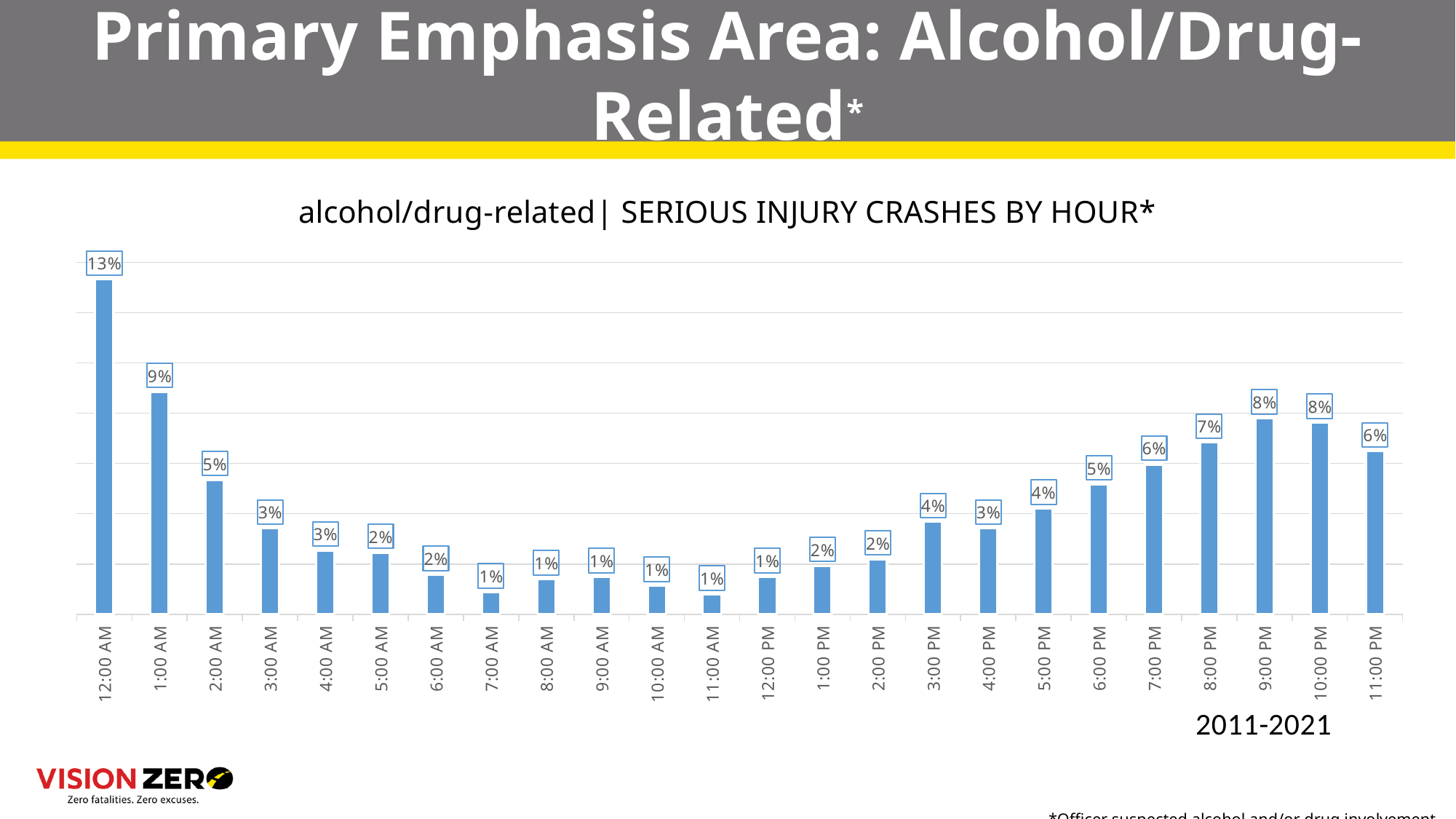
What is the value shown for 3:00 PM? 4% What is the value shown for 2:00 AM? 5% What is the difference between the values for 8:00 PM and 11:00 PM? 1% Which is larger, the value for 6:00 PM or the value for 7:00 PM? 7:00 PM Which is larger, the value for 1:00 AM or the value for 10:00 PM? 1:00 AM What is the difference between the values for 12:00 AM and 1:00 AM? 4% What kind of chart is shown on the slide? Bar chart How many hourly categories are shown on the x axis? 24 What is the value shown for 9:00 PM? 8% Which hour has the highest share of serious injury crashes? 12:00 AM What percentage of alcohol/drug-related serious injury crashes occurred at 12:00 AM? 13% What is the title of the chart? alcohol/drug-related | SERIOUS INJURY CRASHES BY HOUR*